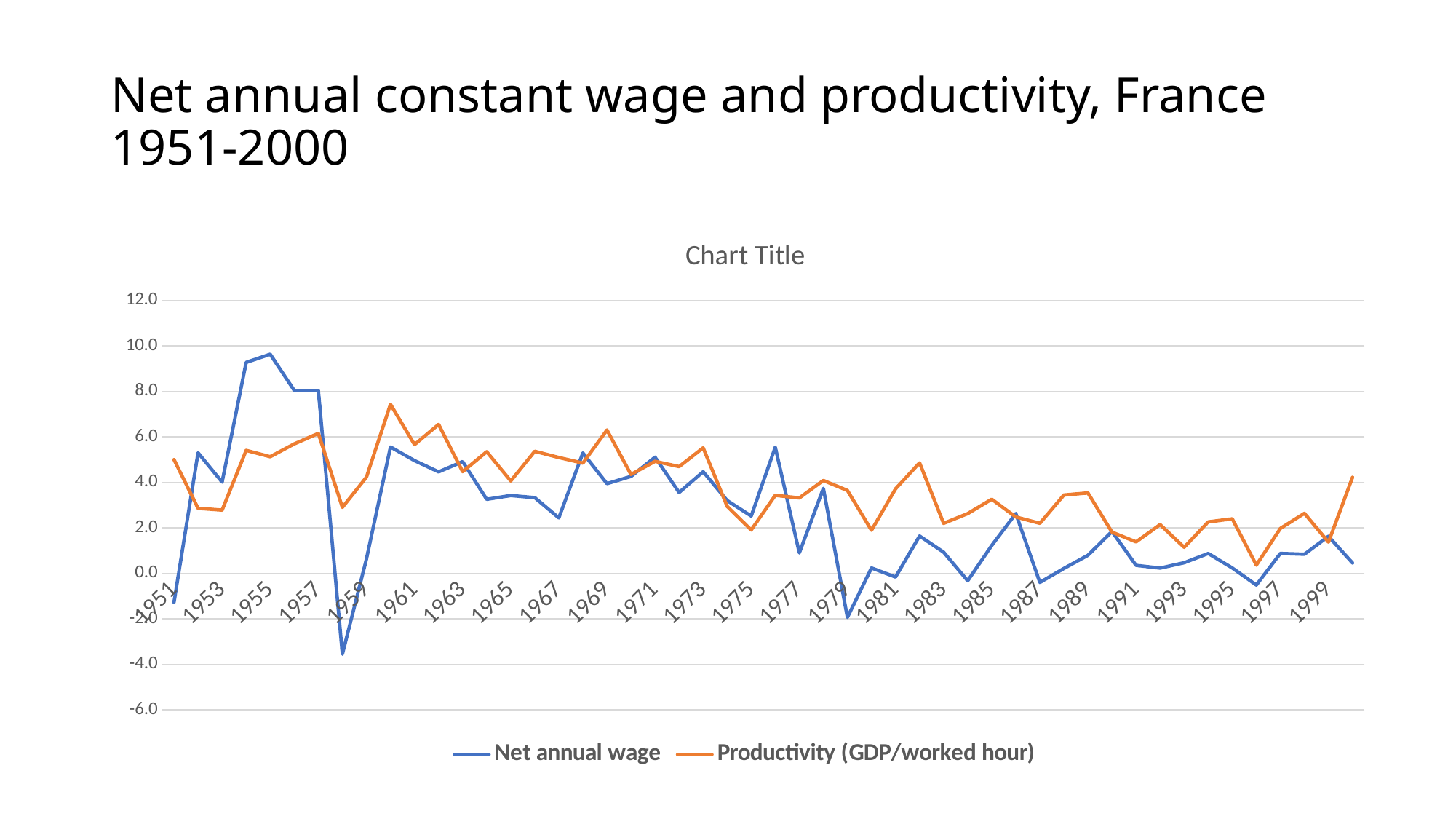
Is the Net annual wage value for 1955 greater or less than 8.0? greater What kind of chart is shown on the slide? Line chart In 1961, which series has the higher value, Net annual wage or Productivity (GDP/worked hour)? Productivity (GDP/worked hour) In 1985, which series has the higher value, Net annual wage or Productivity (GDP/worked hour)? Productivity (GDP/worked hour) Is the Net annual wage value for 1991 greater or less than 2.0? less Is the Productivity (GDP/worked hour) value for 1985 greater or less than 2.0? greater What are the two series named in the legend? Net annual wage; Productivity (GDP/worked hour) Overall, does the Net annual wage line rise or fall from the 1950s to the 1990s? Fall Which series reaches the highest value anywhere on the chart? Net annual wage How many series does the legend list? 2 Which colour is used for the Productivity (GDP/worked hour) line? Orange